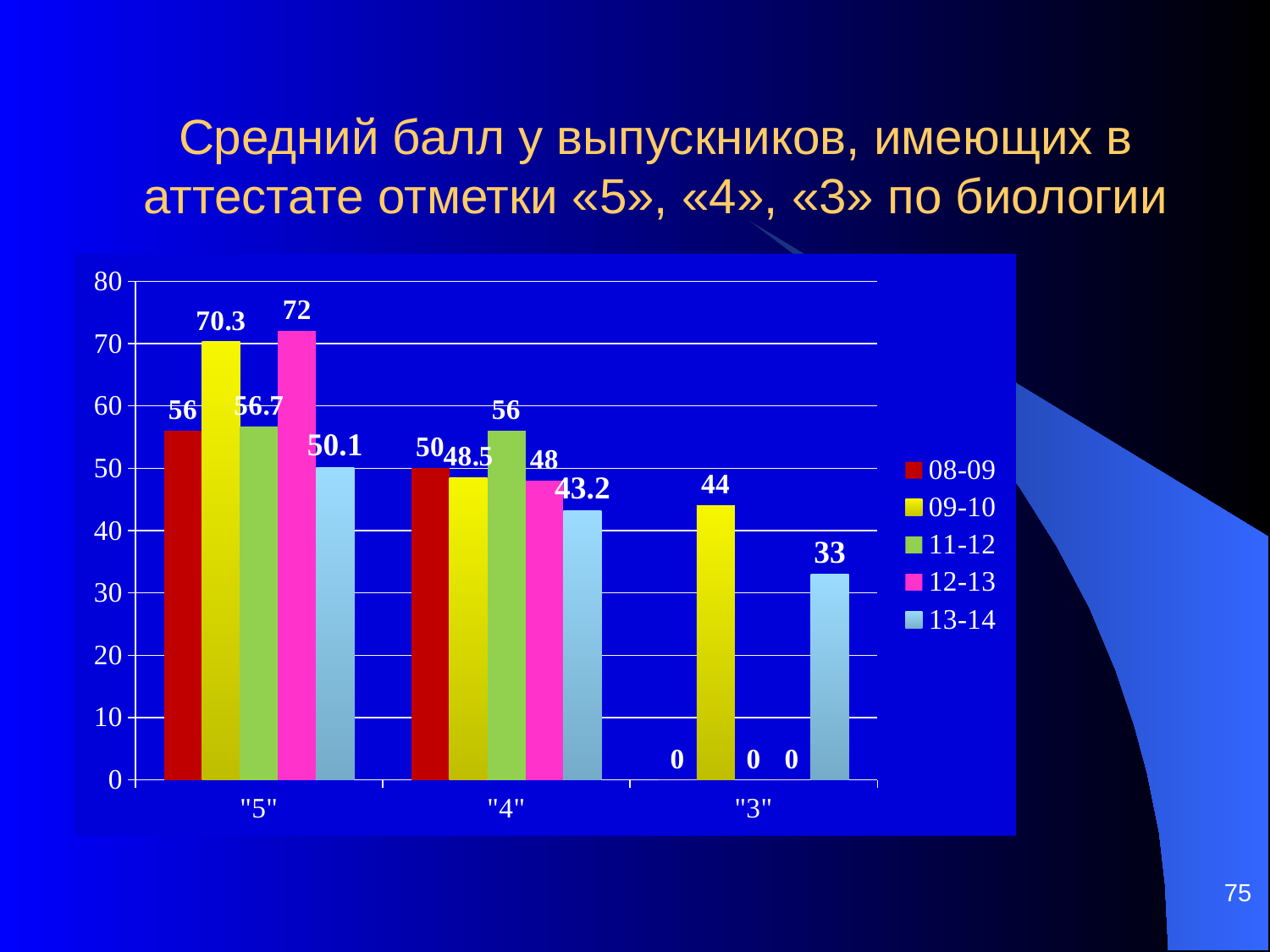
Is the value for the 13-14 series in the "3" category greater or less than 40? less What is the value for the 09-10 series in the "3" category? 44 What kind of chart is shown on the slide? bar chart How many series have a value of 0 in the "3" category? 3 How many categories are shown on the x axis? 3 How many series does the legend list? 5 What is the value for the 12-13 series in the "5" category? 72 What is the value for the 13-14 series in the "4" category? 43.2 Which is larger: the 11-12 value in the "4" category or the 12-13 value in the "4" category? 11-12 Which series has the lowest value in the "4" category? 13-14 What is the difference between the 09-10 and 08-09 values in the "5" category? 14.3 Which series has the highest value in the "5" category? 12-13